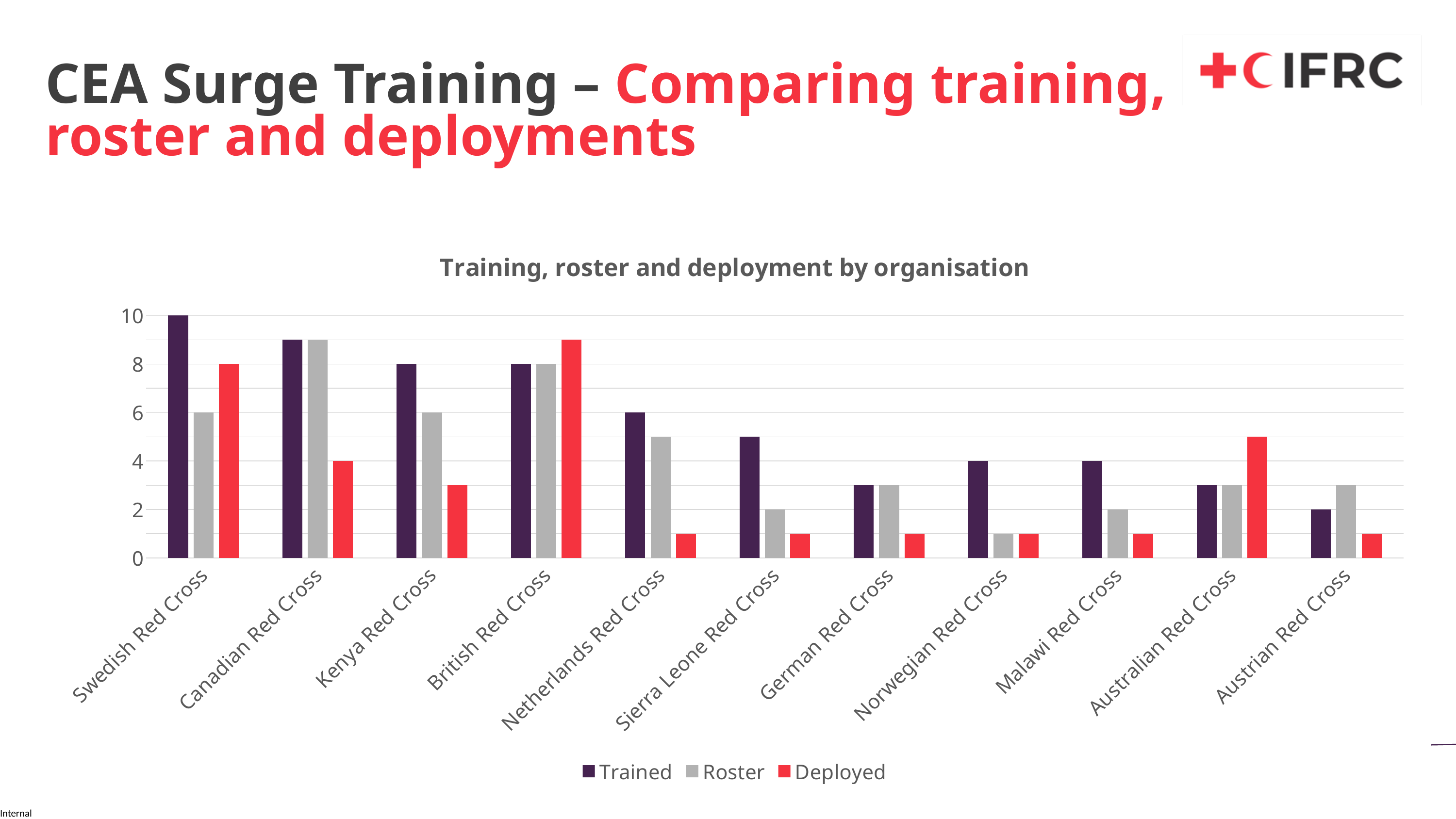
How many series does the legend list? 3 Which organisation has the lowest Trained value? Austrian Red Cross Which organisation has the highest Trained value? Swedish Red Cross What is the Trained value for British Red Cross? 8 What is the Roster value for Kenya Red Cross? 6 Is the Deployed value for British Red Cross greater or less than 8? greater Which is larger for Australian Red Cross, the Trained value or the Deployed value? Deployed What kind of chart is shown on the slide? Bar chart What is the difference between the Trained and Roster values for Swedish Red Cross? 4 How many organisations are shown on the x axis? 11 What is the Trained value for Swedish Red Cross? 10 What is the Deployed value for Swedish Red Cross? 8